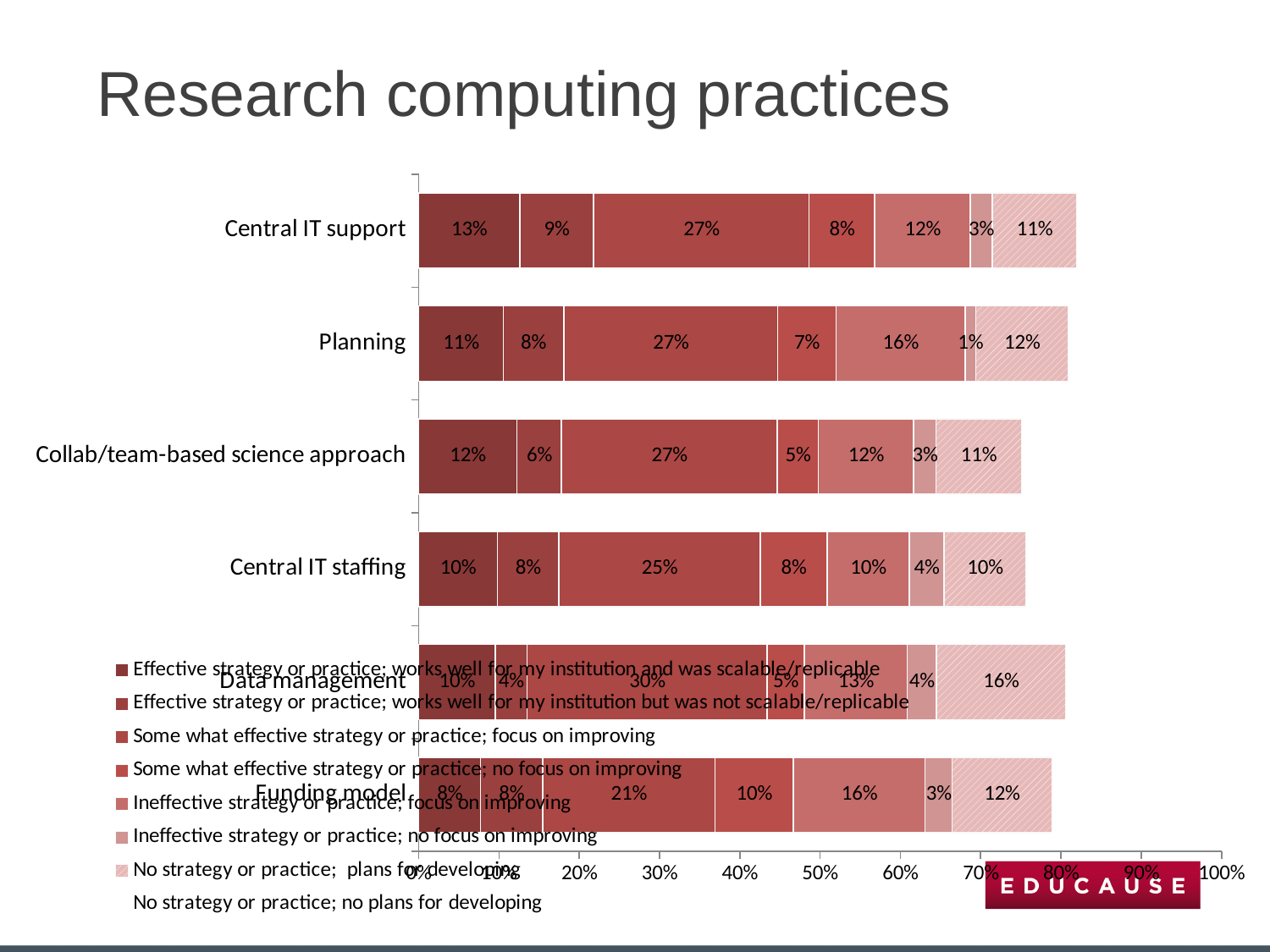
What is the difference between Planning and Central IT support for 'Ineffective strategy or practice; focus on improving'? 4 percentage points How many series does the legend list? 8 Which has the larger 'No strategy or practice; plans for developing' value: Data management or Central IT staffing? Data management How many categories (practices) are plotted on the chart? 6 Which category has the highest value for 'Effective strategy or practice; works well for my institution and was scalable/replicable'? Central IT support What is the title of the chart? Research computing practices What is the value of the 'Ineffective strategy or practice; no focus on improving' segment for Planning? 1% Which category has the lowest value for 'Some what effective strategy or practice; focus on improving'? Funding model What kind of chart is shown on the slide? Stacked bar chart What is the value of the 'Some what effective strategy or practice; focus on improving' segment for Funding model? 21% What is the value of the 'Some what effective strategy or practice; focus on improving' segment for Data management? 30% What percentage of respondents rated Central IT support as 'Effective strategy or practice; works well for my institution and was scalable/replicable'? 13%